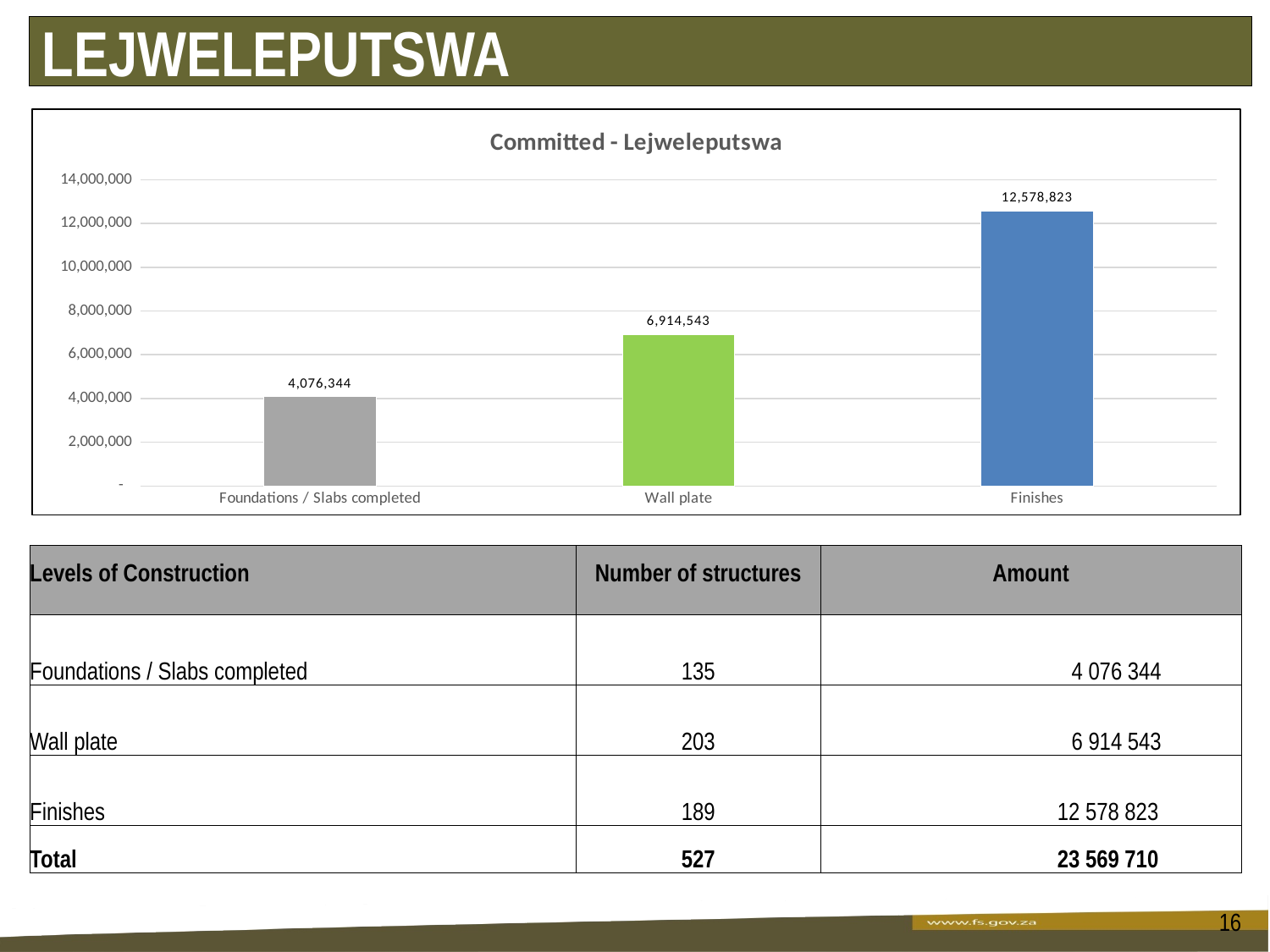
What is the difference between the values for Finishes and Wall plate in the Committed - Lejweleputswa chart? 5,664,280 What is the value for Wall plate in the Committed - Lejweleputswa chart? 6,914,543 What kind of chart is the Committed - Lejweleputswa chart? Bar chart Which category has the lowest value in the Committed - Lejweleputswa chart? Foundations / Slabs completed How many categories are shown in the Committed - Lejweleputswa chart? 3 Do the values rise or fall from left to right across the categories in the Committed - Lejweleputswa chart? Rise Which category has the highest value in the Committed - Lejweleputswa chart? Finishes What is the value for Foundations / Slabs completed in the Committed - Lejweleputswa chart? 4,076,344 What is the value for Finishes in the Committed - Lejweleputswa chart? 12,578,823 Which is larger in the Committed - Lejweleputswa chart, Wall plate or Foundations / Slabs completed? Wall plate Is the value for Finishes in the Committed - Lejweleputswa chart greater or less than 12,000,000? greater What is the difference between the values for Wall plate and Foundations / Slabs completed in the Committed - Lejweleputswa chart? 2,838,199